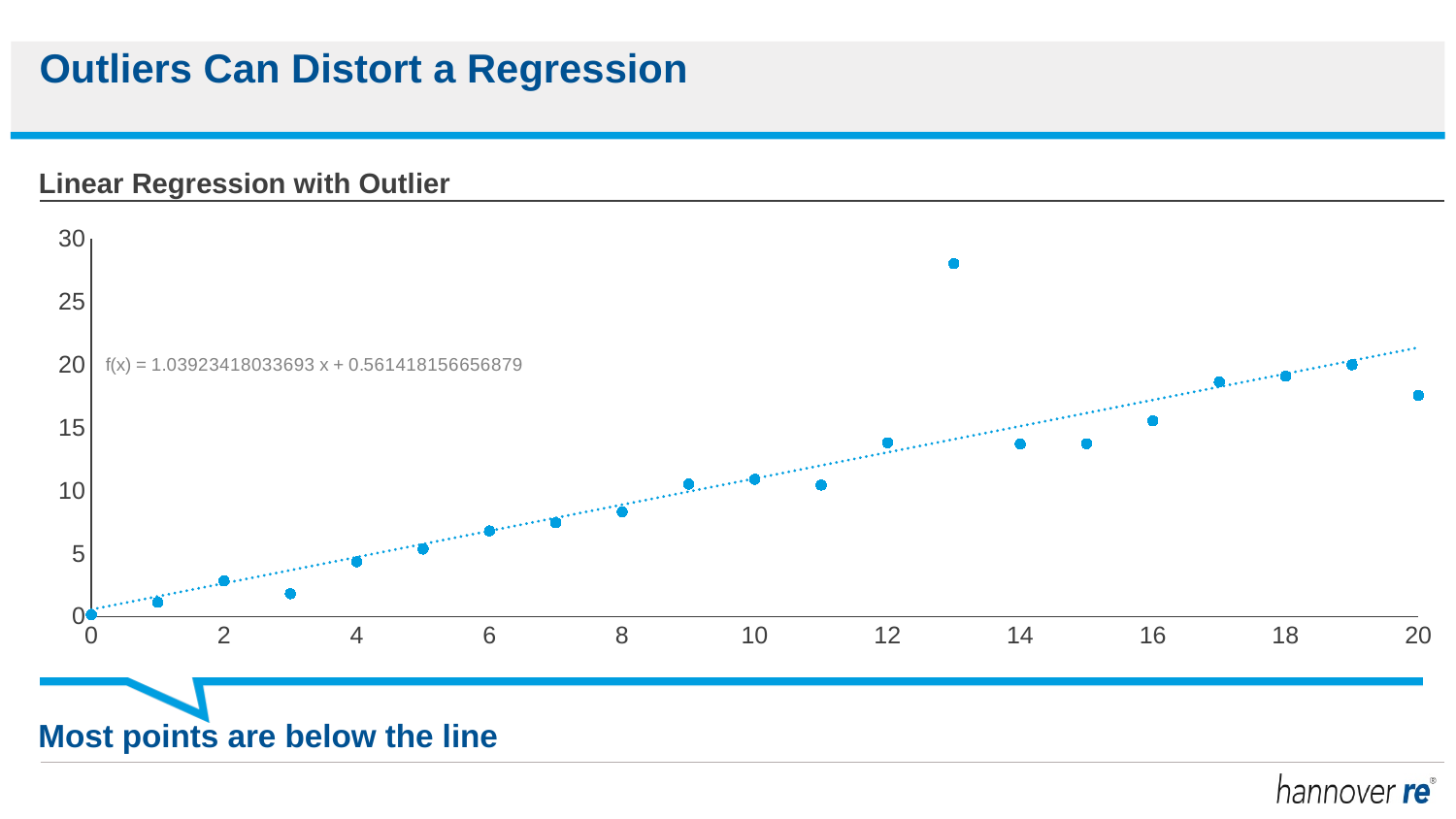
What kind of chart is shown on the slide? scatter chart What is the title of the chart? Linear Regression with Outlier Do the plotted values generally rise or fall as x increases? rise Which has the larger value, the point at x = 13 or the point at x = 19? x = 13 Is the value for x = 20 greater or less than 20? less Is the value for x = 13 greater or less than 25? greater What is the trendline equation printed on the chart? f(x) = 1.03923418033693 x + 0.561418156656879 Is the value for x = 6 greater or less than 5? greater At which x value is the lowest plotted point? 0 How many data points are plotted on the chart? 21 At which x value is the highest plotted point? 13